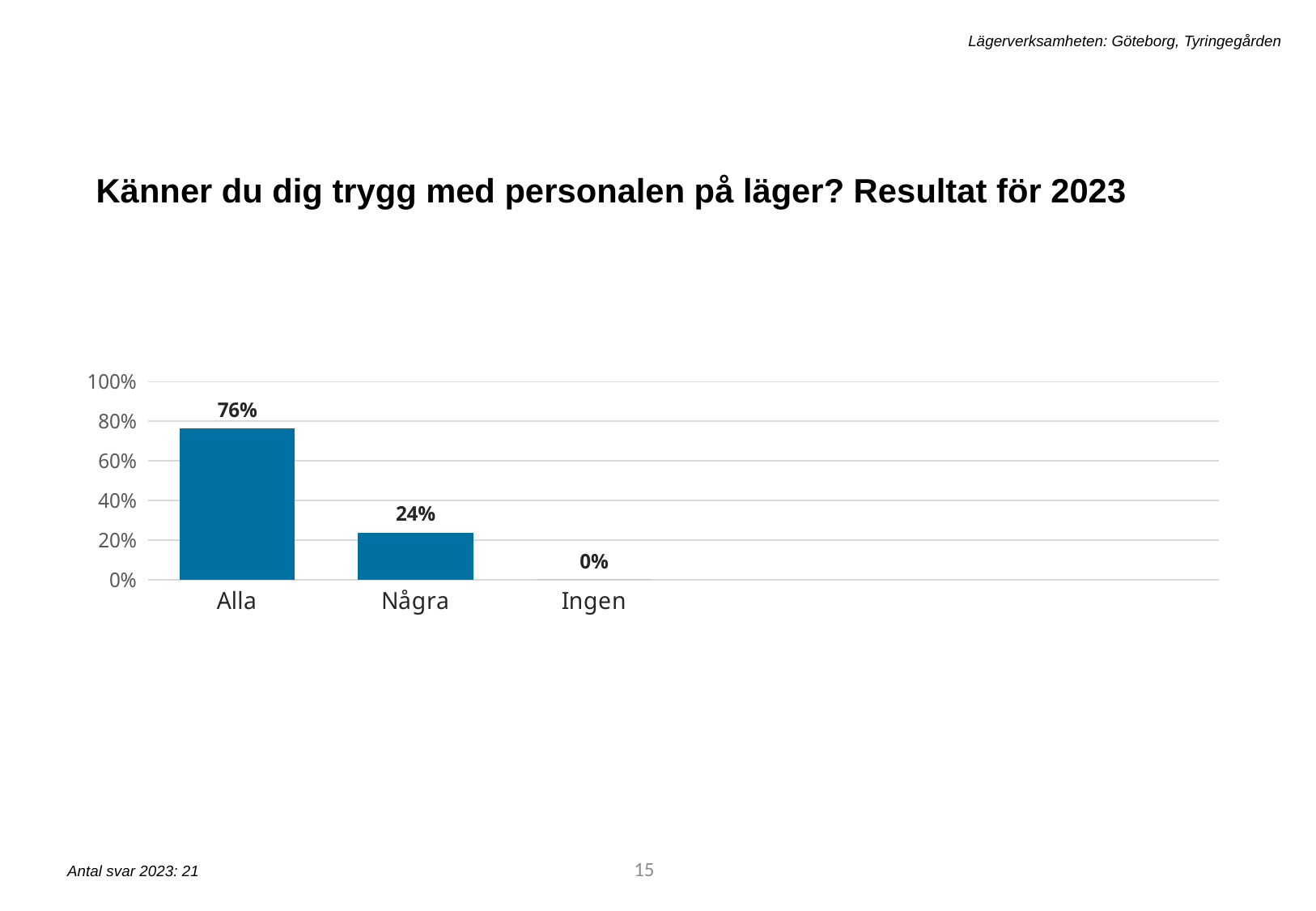
Which category has the highest value? Alla What kind of chart is shown on the slide? bar chart Is the value for Alla greater or less than 60%? greater Do the values rise or fall from left to right along the x axis? fall What is the value for Ingen? 0% Which is larger, the value for Några or the value for Ingen? Några How many categories are shown on the x axis? 3 What is the value for Alla? 76% What is the value for Några? 24% What is the difference between the values for Alla and Några? 52% Which category has the lowest value? Ingen Is the value for Några greater or less than 40%? less